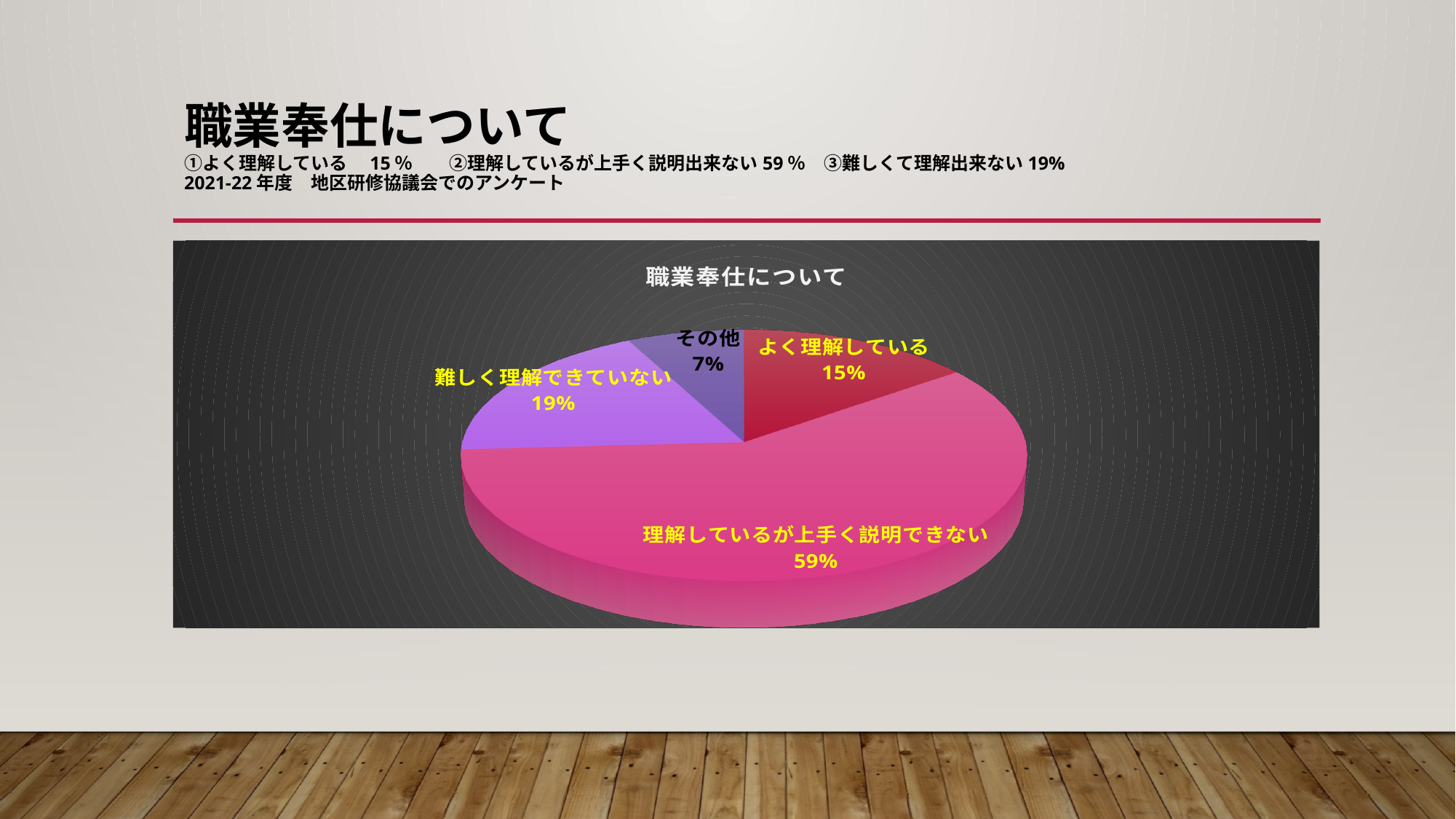
Which is larger, the slice for よく理解している or the slice for 難しく理解できていない? 難しく理解できていない What percentage of the pie is labelled よく理解している? 15% What is the title of the chart? 職業奉仕について What percentage of the pie is labelled 難しく理解できていない? 19% Which slice of the pie is the smallest? その他 How many slices does the pie chart have? 4 What percentage of the pie is labelled 理解しているが上手く説明できない? 59% What kind of chart is shown on the slide? pie chart What is the difference in percentage points between 理解しているが上手く説明できない and 難しく理解できていない? 40 What percentage of the pie is labelled その他? 7% Which slice of the pie is the largest? 理解しているが上手く説明できない What colour is the slice for 理解しているが上手く説明できない? pink